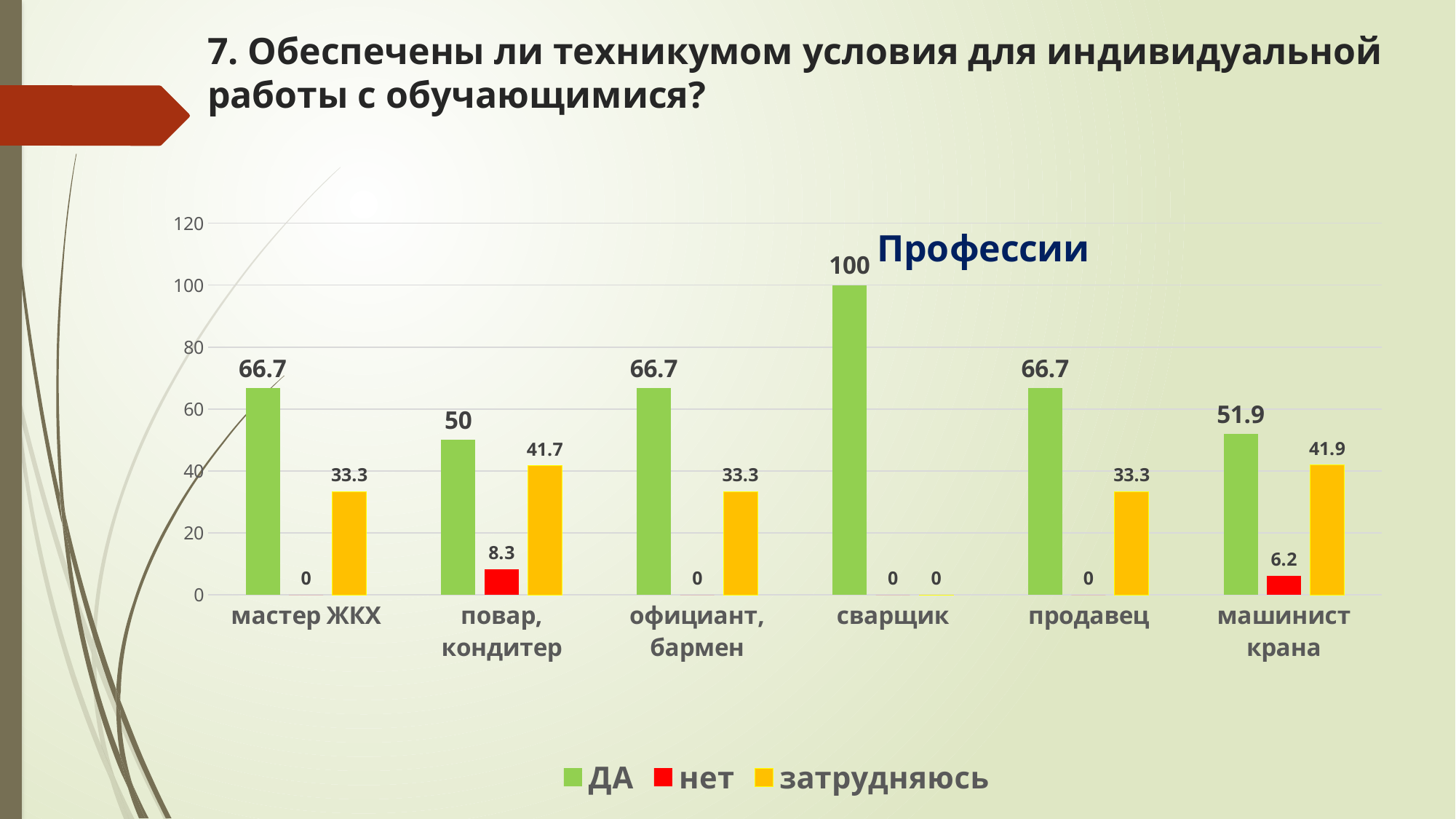
Which profession has the highest ДА value? сварщик What is the difference between the ДА value for сварщик and the ДА value for мастер ЖКХ? 33.3 What is the value of нет for машинист крана? 6.2 How many professions are shown on the x axis? 6 How many series does the legend list? 3 Which profession has the lowest ДА value? повар, кондитер What is the value of ДА for машинист крана? 51.9 What is the value of затрудняюсь for повар, кондитер? 41.7 Which is larger: the затрудняюсь value for машинист крана or the затрудняюсь value for продавец? машинист крана What is the value of ДА for сварщик? 100 Which colour represents the нет series? red What kind of chart is shown on the slide? bar chart